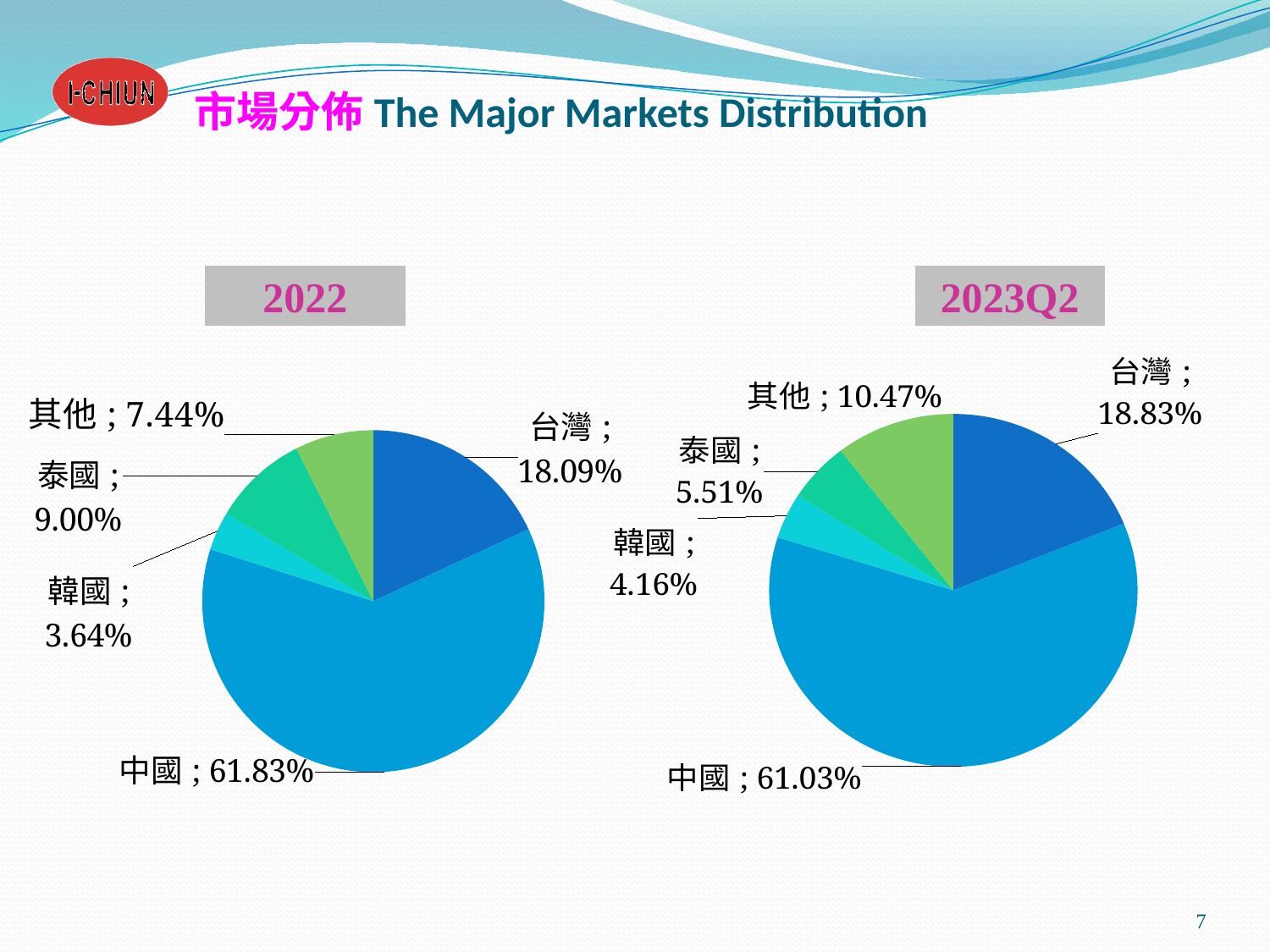
In the 2023Q2 pie chart, what is the value for 韓國? 4.16% What type of chart is used on this slide? Pie chart In the 2022 pie chart, which category has the largest share? 中國 What is the title of the slide? 市場分佈 The Major Markets Distribution In the 2023Q2 pie chart, which category has the smallest share? 韓國 In the 2023Q2 pie chart, what share does 台灣 have? 18.83% In the 2022 pie chart, which category has the smallest share? 韓國 What is the difference between the 其他 share in 2023Q2 and the 其他 share in 2022? 3.03% In the 2022 pie chart, what is the value for 泰國? 9.00% In the 2022 pie chart, what share does 中國 have? 61.83% Which is larger: the 泰國 share in 2022 or the 泰國 share in 2023Q2? 2022 How many categories are shown in the 2023Q2 pie chart? 5